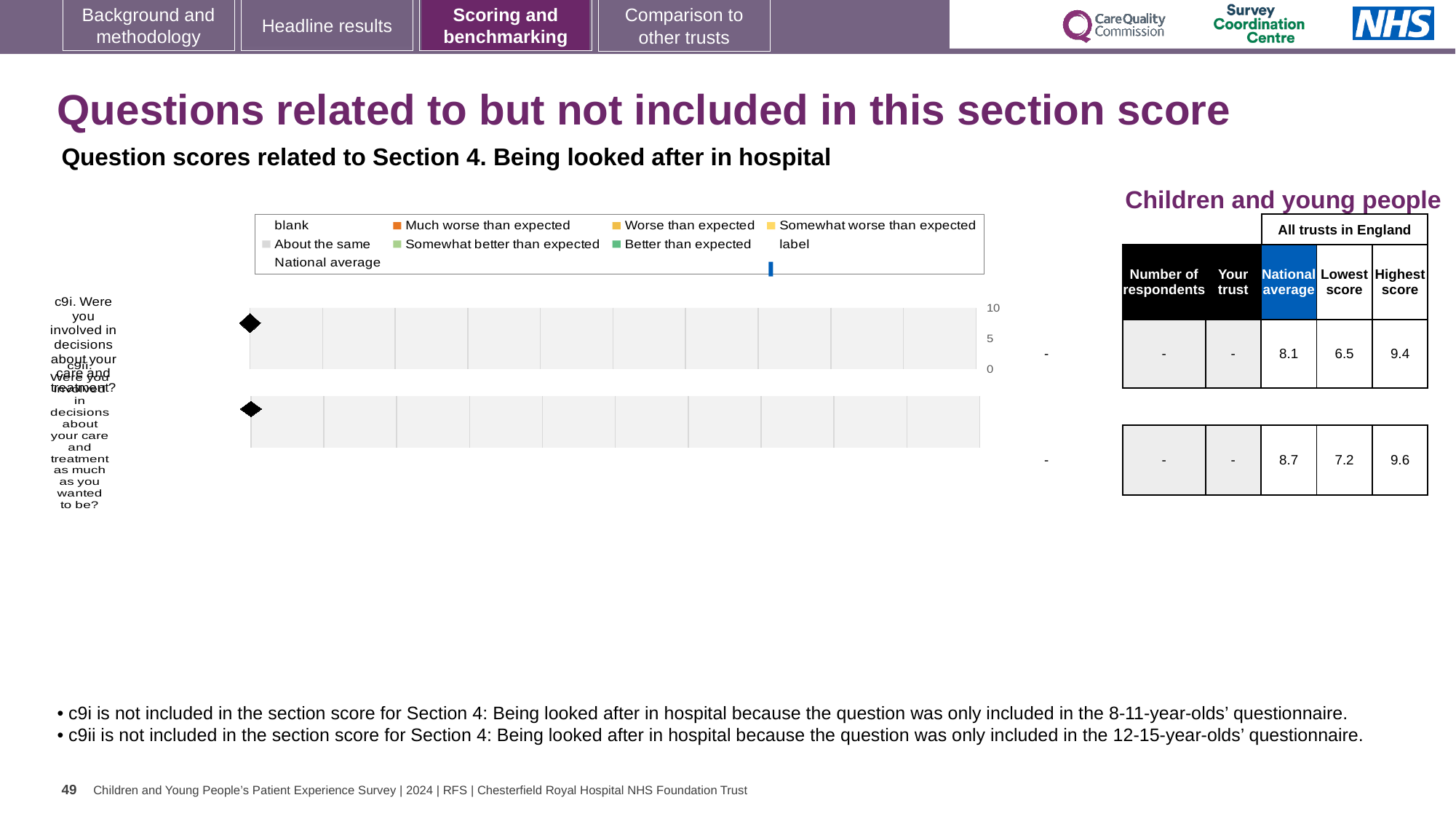
In the table next to the chart, what is the difference between the highest score and the lowest score for c9i? 2.9 In the table next to the chart, what is the national average for c9ii? 8.7 In the table next to the chart, what is the highest score for c9ii? 9.6 What kind of chart is shown on the slide? bar chart In the table next to the chart, which question has the higher highest score, c9i or c9ii? c9ii In the table next to the chart, what is the lowest score for c9i? 6.5 How many question categories are plotted on the chart? 2 What is the maximum value shown on the chart's axis? 10 What colour does the legend use for 'Much worse than expected'? orange In the table next to the chart, what is the national average for c9i? 8.1 In the table next to the chart, what is the difference between the national averages of c9ii and c9i? 0.6 In the table next to the chart, what value is shown for 'Your trust' for c9i? -